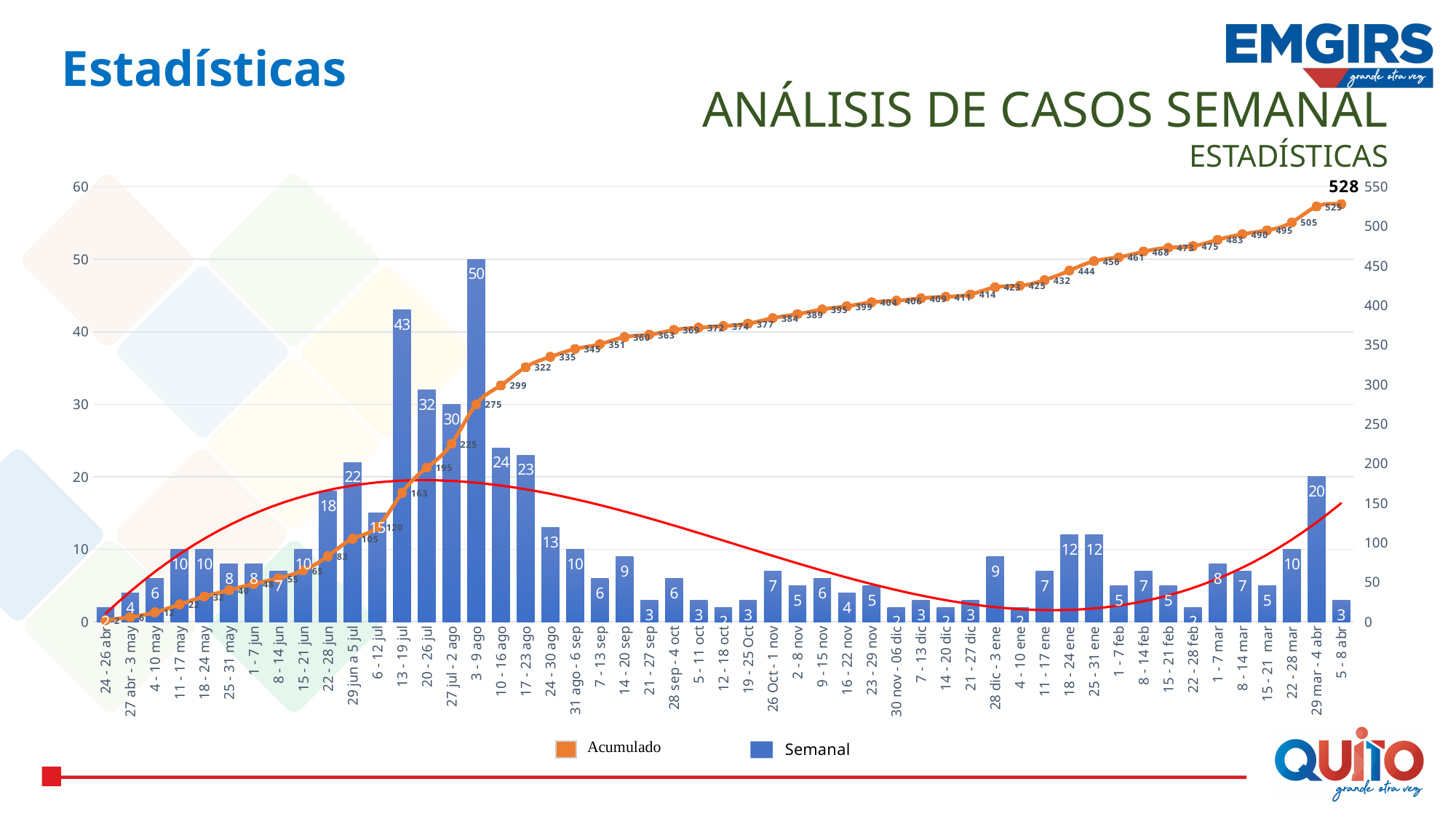
What is the difference between the Semanal values for 3 - 9 ago and 13 - 19 jul? 7 Which week has the highest Semanal value? 3 - 9 ago What is the Semanal value for the week 13 - 19 jul? 43 What is the Acumulado value for the week 3 - 9 ago? 275 Which week has the larger Semanal value, 18 - 24 ene or 1 - 7 feb? 18 - 24 ene What is the final Acumulado value shown at the end of the line (5 - 8 abr)? 528 What are the two series named in the legend? Acumulado and Semanal What is the Semanal value for the week 3 - 9 ago? 50 How many series does the legend list? 2 Does the Acumulado line rise or fall from left to right along the x axis? Rises What is the Semanal value for the week 29 mar - 4 abr? 20 What kind of chart is used to show the Semanal series? Bar chart